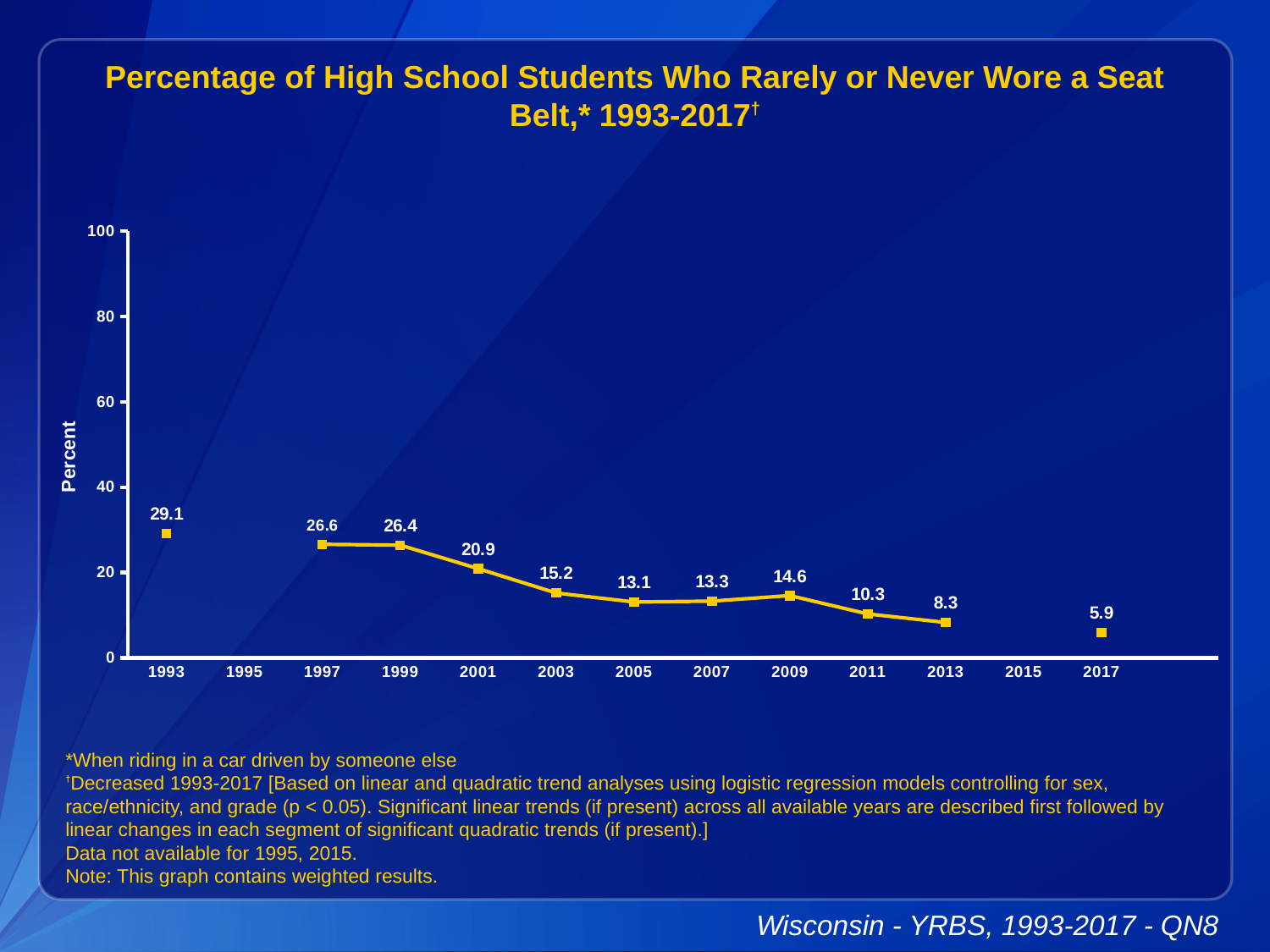
What is the value plotted for 2009? 14.6 What is the label on the y axis? Percent How many data points are plotted on the chart? 11 What is the difference between the 1993 value and the 2017 value? 23.2 Is the value for 1997 greater or less than 20? greater What is the value plotted for 2017? 5.9 Which year has the highest percentage? 1993 What kind of chart is shown on the slide? line chart Which year has the larger value, 2001 or 2003? 2001 What percentage of high school students rarely or never wore a seat belt in 1993? 29.1 Do the values generally rise or fall from 1993 to 2017? fall Which year has the lowest percentage? 2017